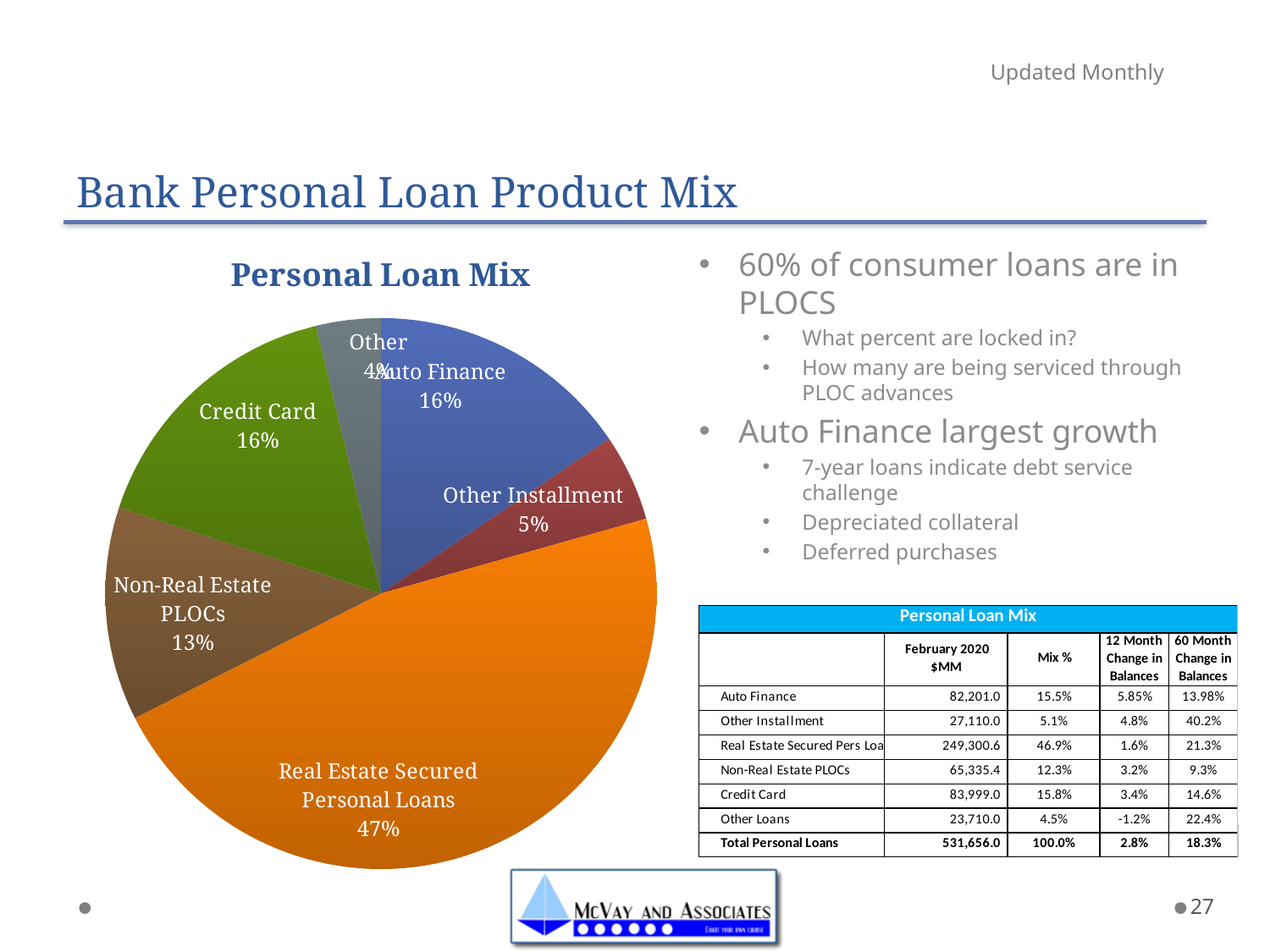
What is the difference in percentage points between Real Estate Secured Personal Loans and Non-Real Estate PLOCs? 34 What share of the pie is Non-Real Estate PLOCs? 13% What type of chart is shown on the slide? Pie chart What is the title of the chart? Personal Loan Mix Which category has the largest slice of the pie? Real Estate Secured Personal Loans What share of the pie is Other? 4% What share of the pie is Credit Card? 16% Which category has the smallest slice of the pie? Other How many slices does the pie chart have? 6